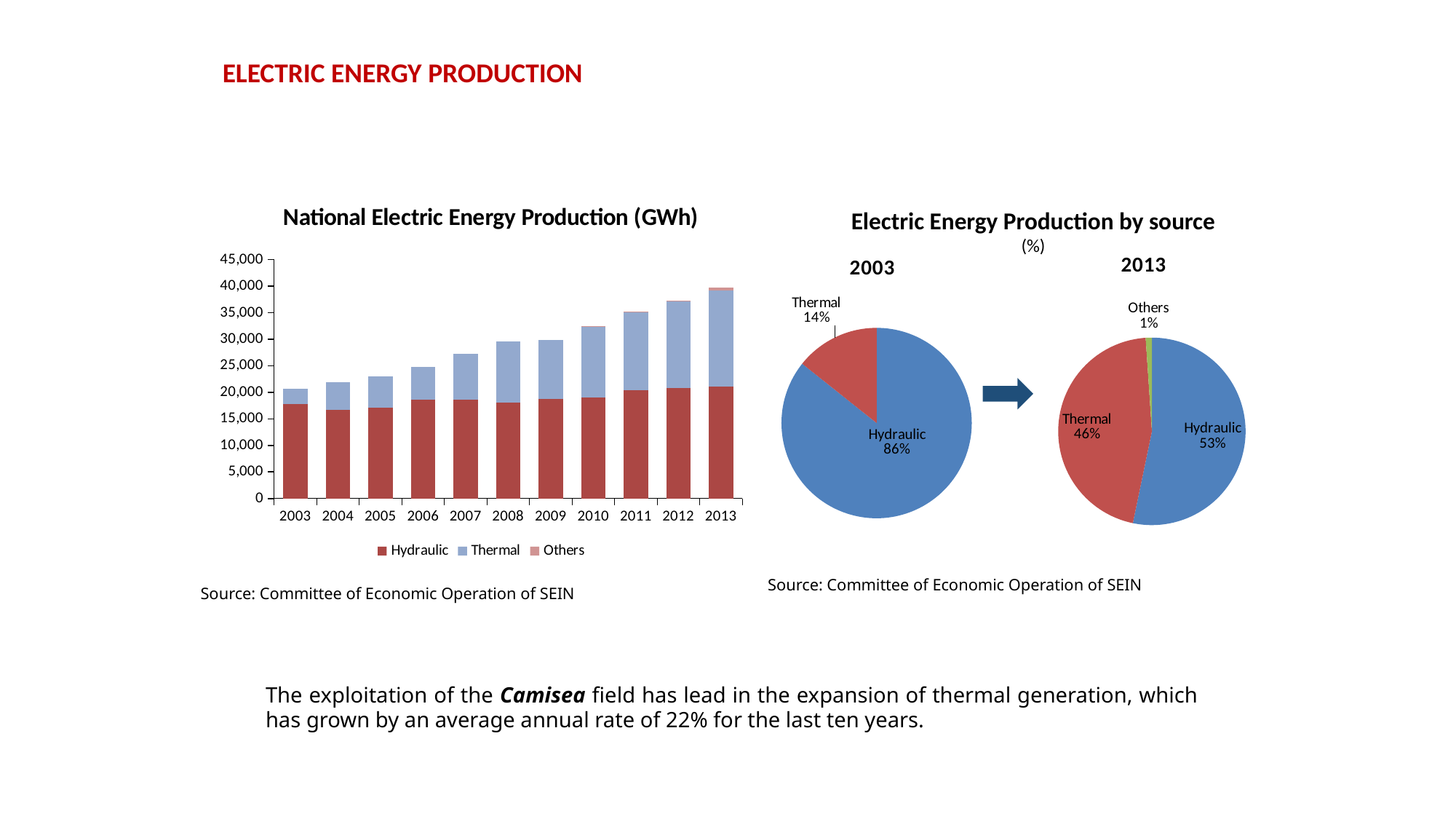
What kind of chart is the 'National Electric Energy Production (GWh)' chart? Stacked bar chart In the 'Electric Energy Production by source' 2013 pie chart, what is the difference between the Hydraulic and Thermal shares? 7% In the 'National Electric Energy Production (GWh)' chart, is the total production for 2013 greater or less than 35,000? greater In the 'National Electric Energy Production (GWh)' chart, does total production generally rise or fall from 2003 to 2013? Rise How many years are shown on the x axis of the 'National Electric Energy Production (GWh)' chart? 11 In the 'National Electric Energy Production (GWh)' chart, which year has the highest total production? 2013 In the 'Electric Energy Production by source' 2003 pie chart, what share is Hydraulic? 86% In the 'National Electric Energy Production (GWh)' chart, is the total production for 2007 greater or less than 25,000? greater In the 'Electric Energy Production by source' 2013 pie chart, what share is Thermal? 46% In the 'National Electric Energy Production (GWh)' chart, which year has the lowest total production? 2003 How many series does the legend of the 'National Electric Energy Production (GWh)' chart list? 3 In the 'Electric Energy Production by source' 2013 pie chart, which slice is the smallest? Others